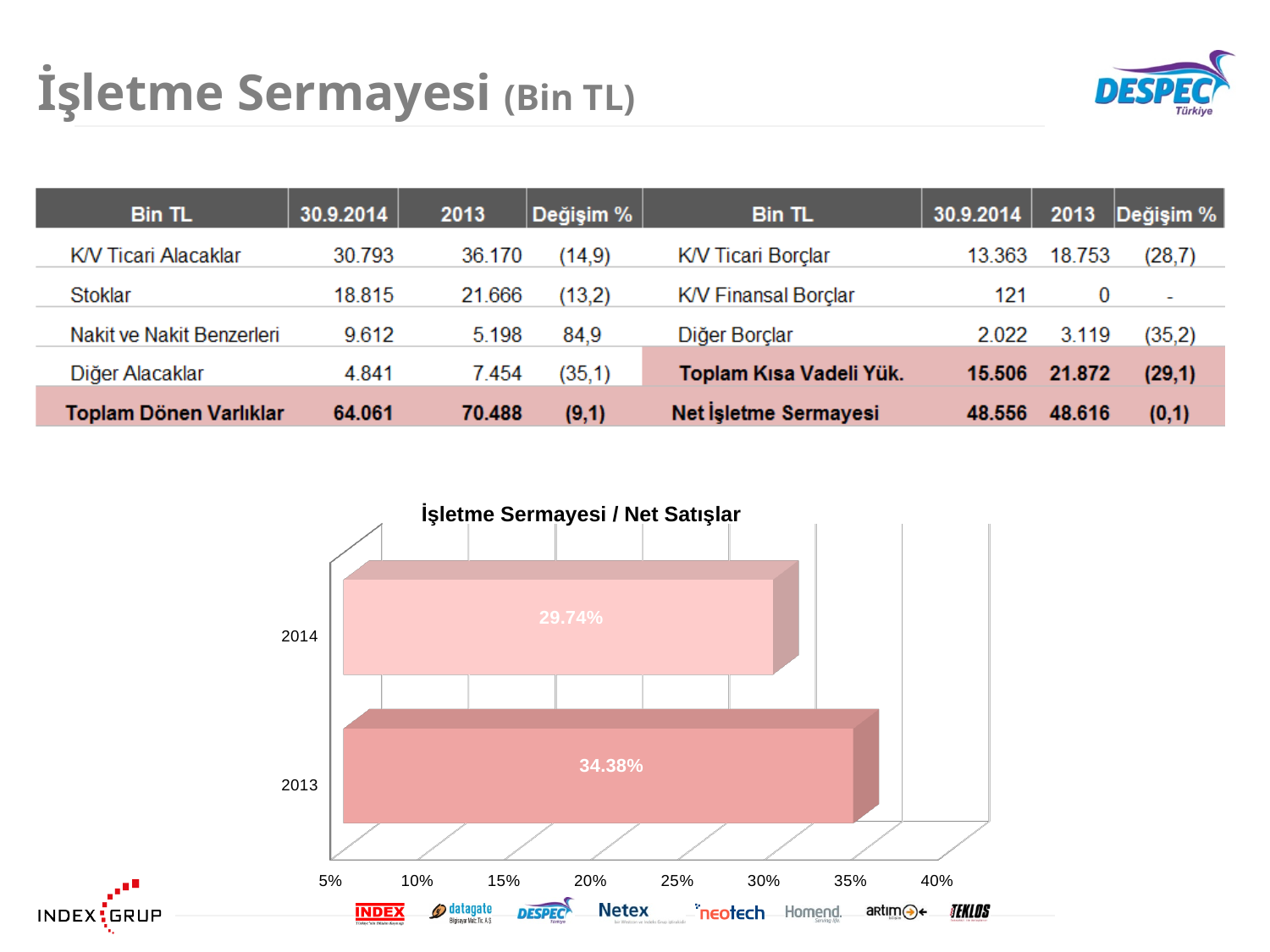
Is the value for 2014 larger or smaller than the value for 2013 in the İşletme Sermayesi / Net Satışlar chart? smaller How many bars are shown in the İşletme Sermayesi / Net Satışlar chart? 2 What is the value for 2013 in the İşletme Sermayesi / Net Satışlar chart? 34.38% Which year has the higher value in the İşletme Sermayesi / Net Satışlar chart? 2013 Is the value for 2014 in the İşletme Sermayesi / Net Satışlar chart greater or less than 30%? less What is the value for 2014 in the İşletme Sermayesi / Net Satışlar chart? 29.74% Does the ratio in the İşletme Sermayesi / Net Satışlar chart rise or fall from 2013 to 2014? fall Is the value for 2013 in the İşletme Sermayesi / Net Satışlar chart greater or less than 30%? greater What is the title of the chart on the slide? İşletme Sermayesi / Net Satışlar What is the difference between the 2013 and 2014 values in the İşletme Sermayesi / Net Satışlar chart? 4.64% What kind of chart is the İşletme Sermayesi / Net Satışlar chart? bar chart Which year has the lower value in the İşletme Sermayesi / Net Satışlar chart? 2014